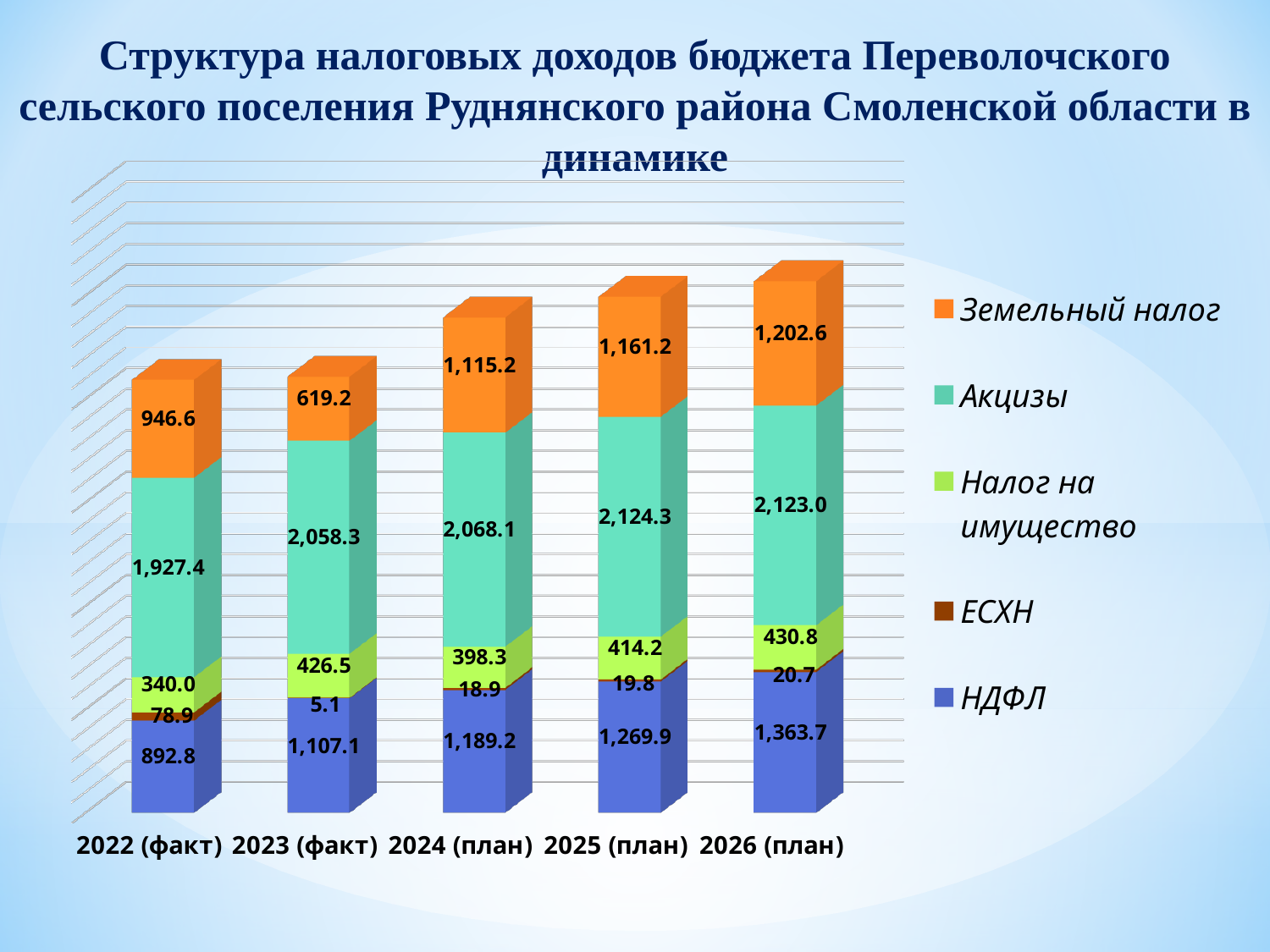
What is the total of the stacked bar for 2026 (план)? 5,140.8 Does НДФЛ rise or fall from 2022 (факт) to 2026 (план)? rises Which is larger: Налог на имущество in 2023 (факт) or in 2024 (план)? 2023 (факт) In which year is Земельный налог the highest? 2026 (план) How many categories (years) are shown on the x axis? 5 In which year is ЕСХН the lowest? 2023 (факт) What is the value of Акцизы for 2024 (план)? 2,068.1 How many series does the legend list? 5 What is the difference between Земельный налог in 2022 (факт) and 2023 (факт)? 327.4 What is the value of НДФЛ for 2022 (факт)? 892.8 What type of chart is shown on the slide? stacked bar chart What is the value of ЕСХН for 2023 (факт)? 5.1